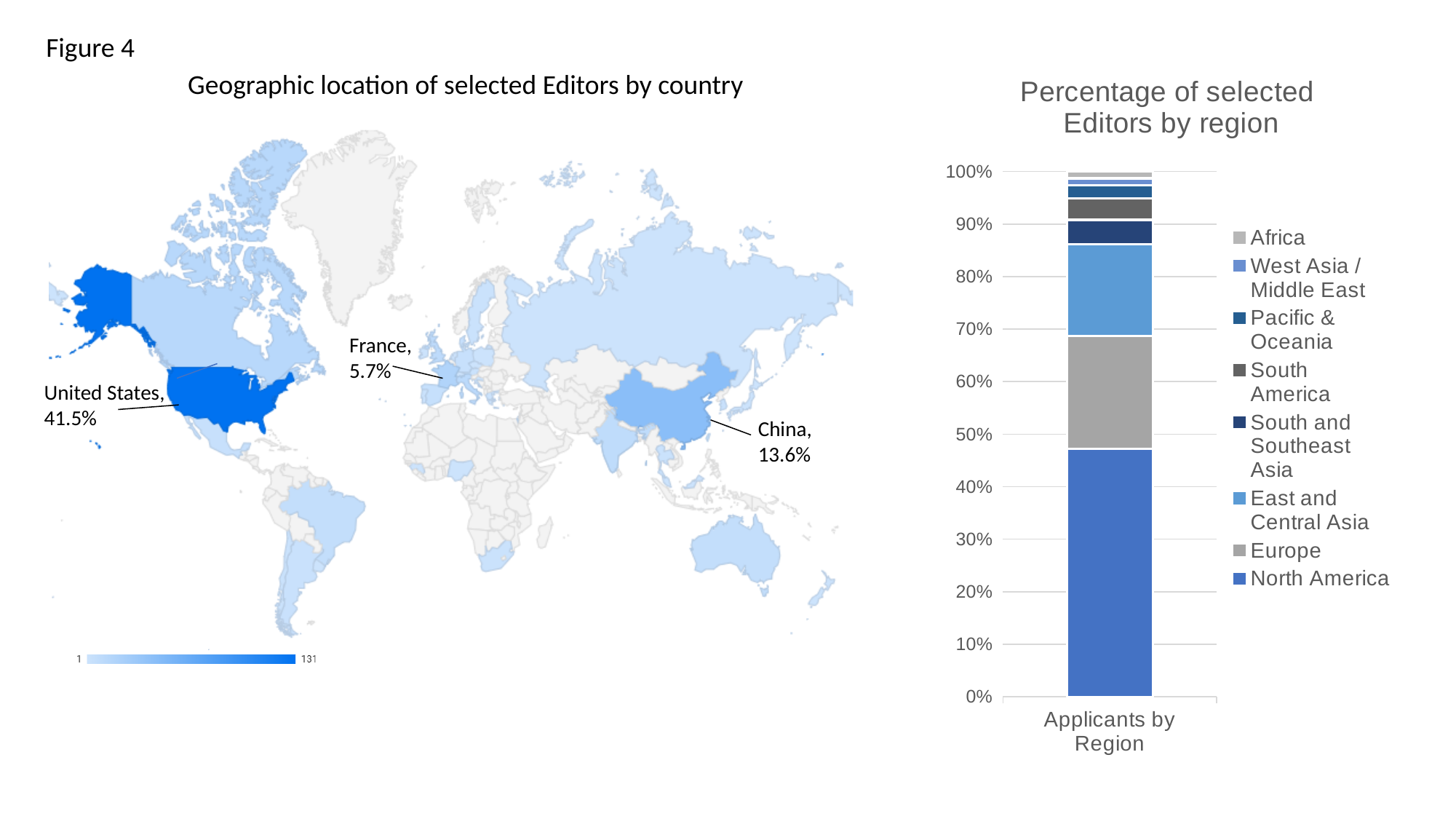
In the chart 'Percentage of selected Editors by region', which region has the largest segment of the stacked bar? North America On the map chart 'Geographic location of selected Editors by country', what percentage is labelled for China? 13.6% What kind of chart is 'Percentage of selected Editors by region'? Stacked bar chart On the map chart 'Geographic location of selected Editors by country', which has a larger labelled percentage, China or France? China In the chart 'Percentage of selected Editors by region', what is the category label shown on the x axis? Applicants by Region On the map chart 'Geographic location of selected Editors by country', what percentage is labelled for the United States? 41.5% On the map chart 'Geographic location of selected Editors by country', what is the difference in percentage points between the United States and China? 27.9 In the chart 'Percentage of selected Editors by region', is the value for North America greater or less than 40%? greater On the map chart 'Geographic location of selected Editors by country', which of the labelled countries has the highest percentage? United States How many regions does the legend of the chart 'Percentage of selected Editors by region' list? 8 On the map chart 'Geographic location of selected Editors by country', what percentage is labelled for France? 5.7% On the map chart 'Geographic location of selected Editors by country', which of the labelled countries has the lowest percentage? France